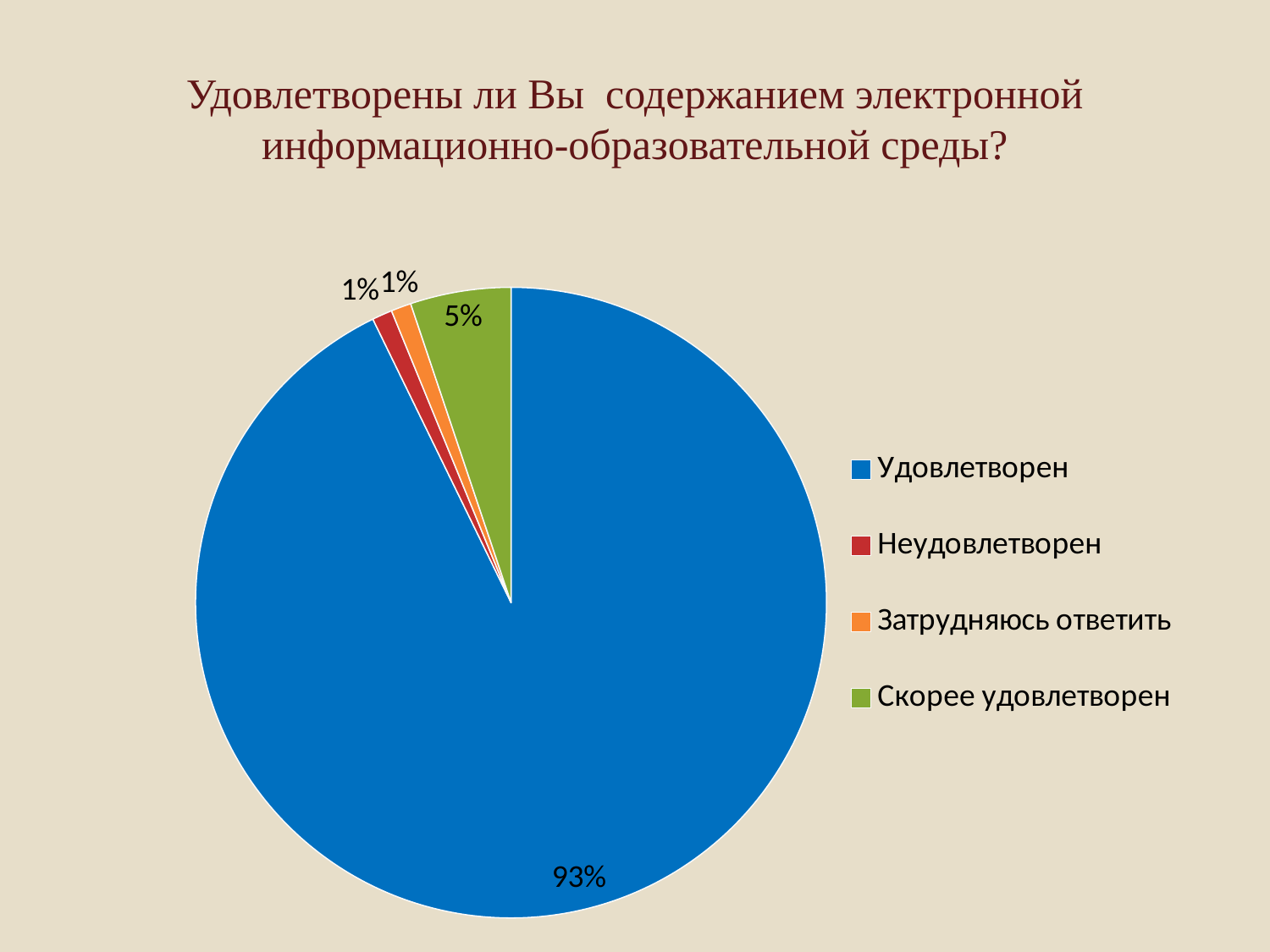
What is the value for "Скорее удовлетворен"? 5% What colour is the slice for "Скорее удовлетворен"? green What type of chart is shown on the slide? pie chart How many entries does the legend list? 4 How many categories does the pie chart have? 4 What is the difference between the values for "Удовлетворен" and "Скорее удовлетворен"? 88% What is the title of the chart on the slide? Удовлетворены ли Вы содержанием электронной информационно-образовательной среды? What is the value for "Затрудняюсь ответить"? 1% What is the value for "Неудовлетворен"? 1% Which is larger, the value for "Скорее удовлетворен" or the value for "Неудовлетворен"? Скорее удовлетворен Which category has the largest slice of the pie? Удовлетворен What share of the pie does "Удовлетворен" take? 93%